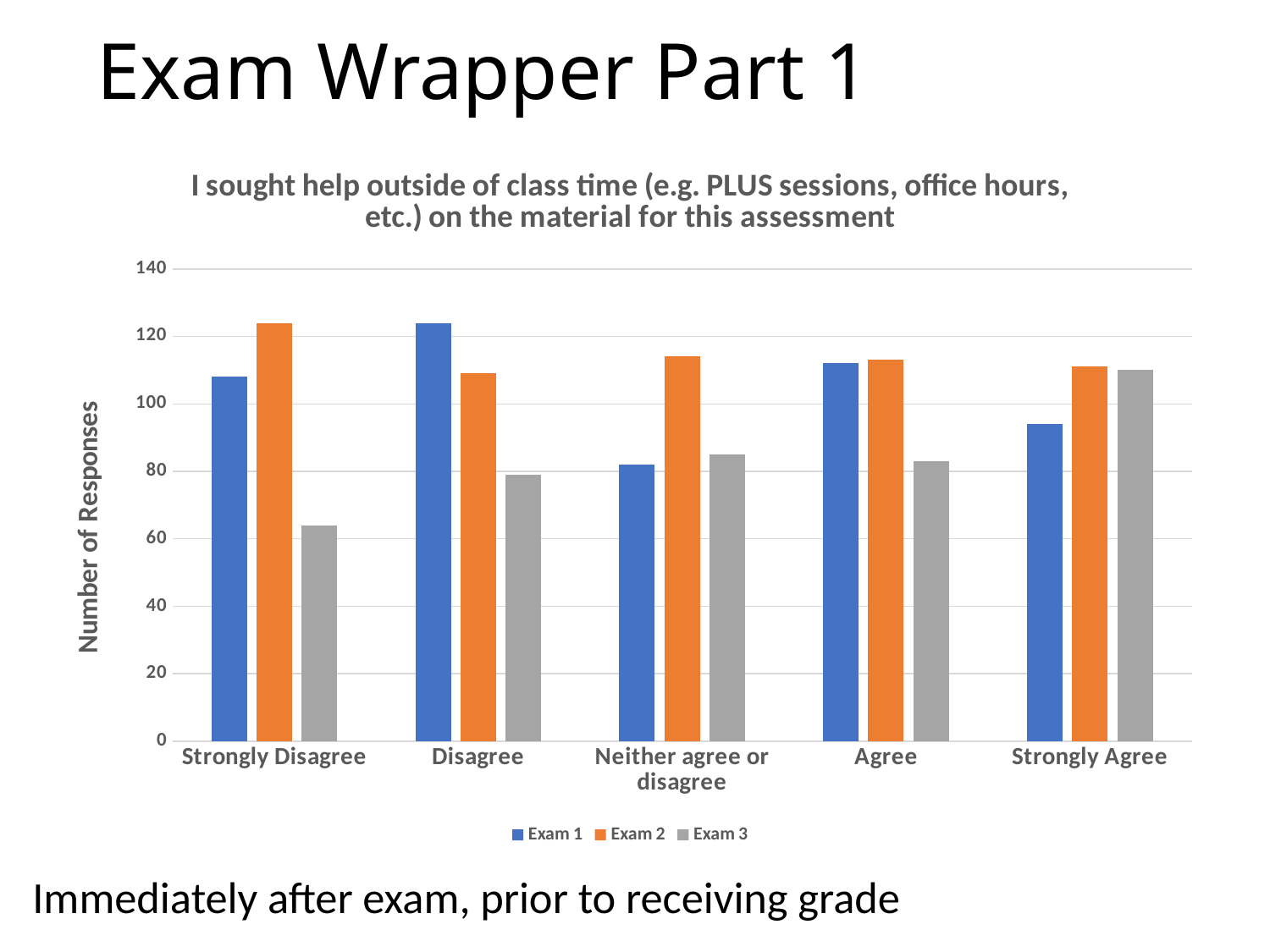
Is the value for Exam 3 in the Agree category greater or less than 100? less How many series does the legend list? 3 In the Strongly Disagree category, which is larger: Exam 2 or Exam 3? Exam 2 Is the value for Exam 3 in the Strongly Disagree category greater or less than 80? less In the Neither agree or disagree category, which is larger: Exam 1 or Exam 2? Exam 2 For Exam 3, which category has the lowest number of responses? Strongly Disagree What is the label on the y axis of the chart? Number of Responses Is the value for Exam 1 in the Disagree category greater or less than 100? greater For Exam 1, which category has the highest number of responses? Disagree How many response categories are shown on the x axis? 5 What kind of chart is shown on the slide? bar chart